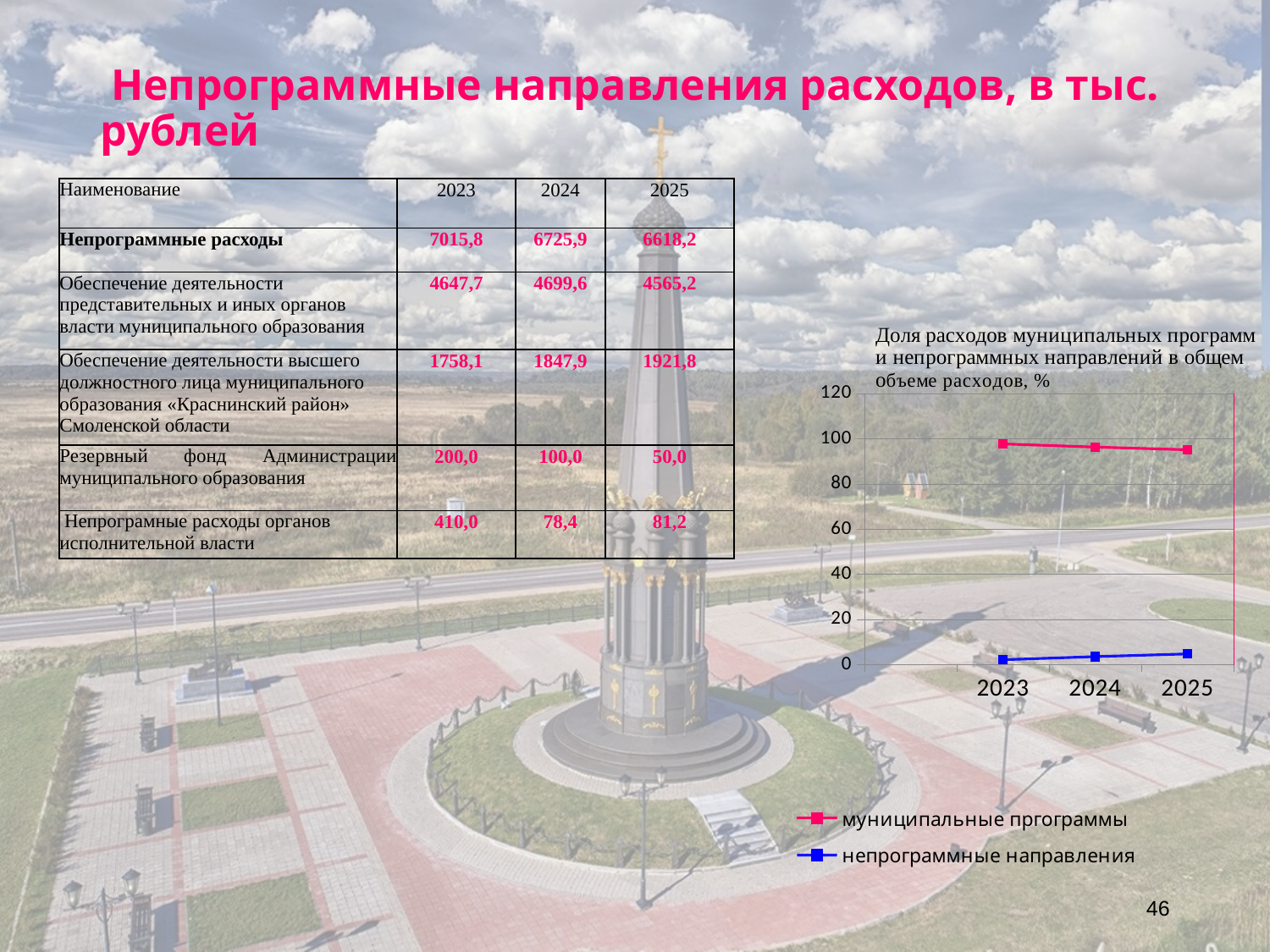
Which colour is used for the series «непрограммные направления» in the chart? blue How many years are plotted along the x axis of the chart? 3 In the chart, is the value for «непрограммные направления» in 2025 greater or less than 20? less What is the title of the chart? Доля расходов муниципальных программ и непрограммных направлений в общем объеме расходов, % In the chart, does the line for «непрограммные направления» rise or fall from 2023 to 2025? rise In the chart, which series has the higher value in 2024, «муниципальные программы» or «непрограммные направления»? муниципальные программы In the chart, does the line for «муниципальные программы» rise or fall from 2023 to 2025? fall What kind of chart is shown on the right side of the slide? line chart In the chart, is the value for «муниципальные программы» in 2025 greater or less than 100? less In the chart, in which year is the value for «непрограммные направления» highest? 2025 How many series does the legend of the chart list? 2 In the chart, is the value for «муниципальные программы» in 2023 greater or less than 80? greater